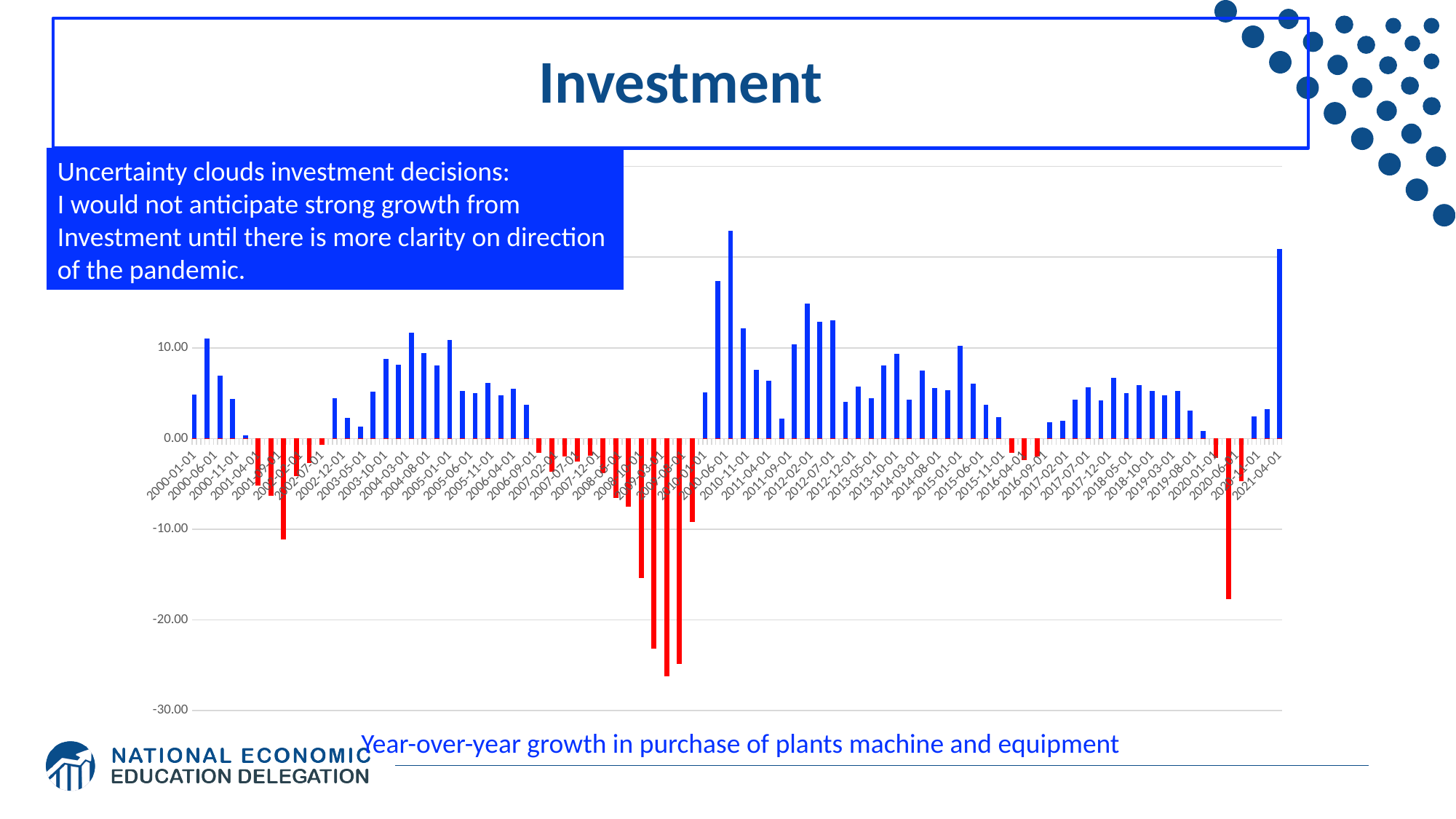
Is the value for 2000-01-01 greater or less than 10? less In which year do the deepest negative bars on the chart occur? 2009 Which is larger, the value for 2000-01-01 or the value for 2021-04-01? 2021-04-01 Is the value for 2021-04-01 greater or less than 10? greater Do the values rise or fall over the last three bars of the chart? rise Are there more positive (blue) bars or negative (red) bars on the chart? positive (blue) Is the lowest value on the chart greater or less than -20? less What is the title of the slide containing the chart? Investment What is the lowest value shown on the vertical axis? -30.00 What kind of chart is shown on the slide? bar chart What does the caption below the chart say the bars represent? Year-over-year growth in purchase of plants machine and equipment